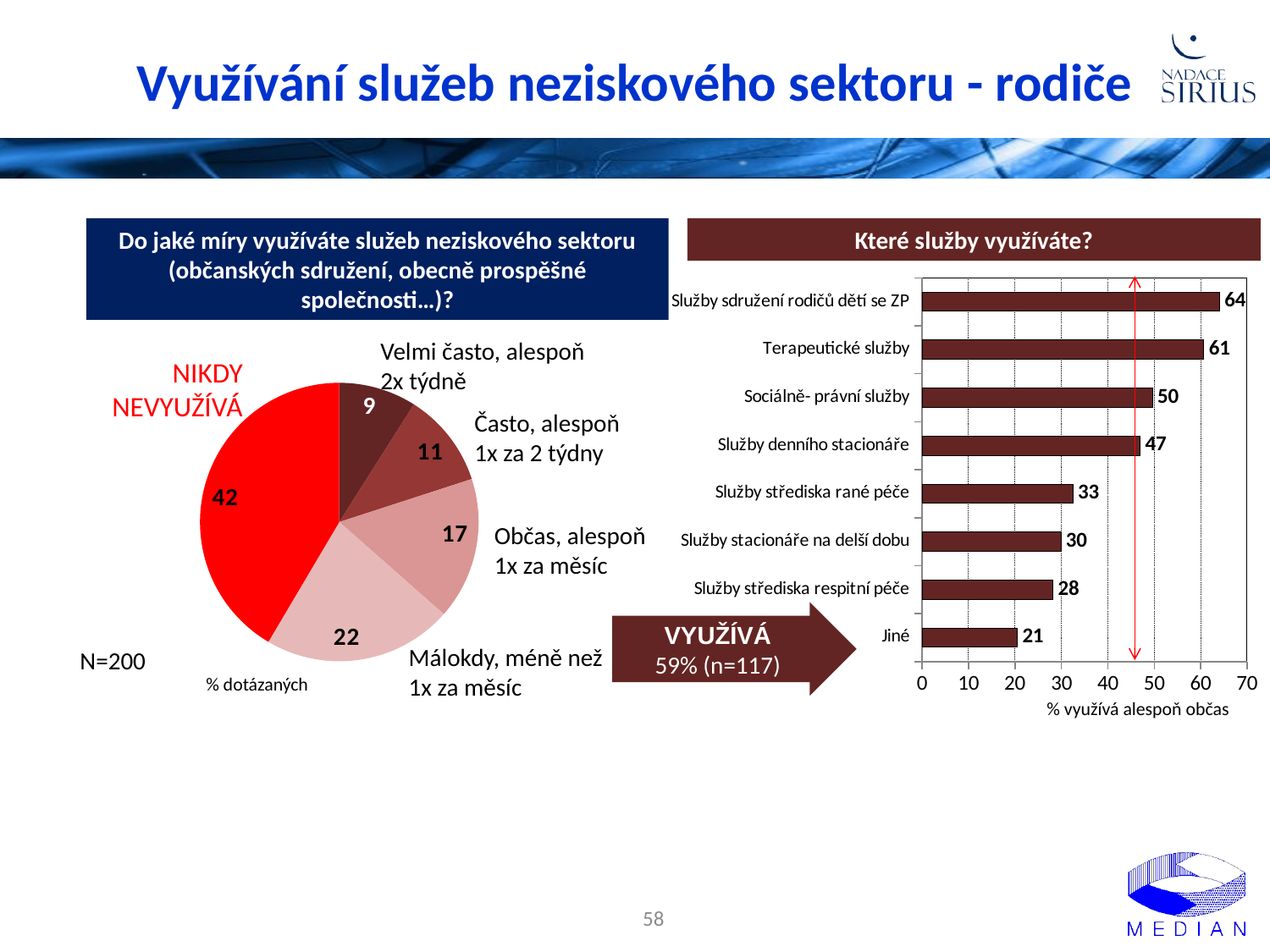
What type of chart is the 'Které služby využíváte?' chart? Bar chart In the 'Které služby využíváte?' chart, what is the difference between 'Sociálně- právní služby' and 'Služby denního stacionáře'? 3 In the pie chart on the left, which category has the smallest slice? Velmi často, alespoň 2x týdně In the pie chart on the left, how many slices are there? 5 In the pie chart on the left, what percentage of respondents answered 'NIKDY NEVYUŽÍVÁ'? 42 In the pie chart on the left, what is the difference between 'Málokdy, méně než 1x za měsíc' and 'Občas, alespoň 1x za měsíc'? 5 In the pie chart on the left, which category has the largest slice? NIKDY NEVYUŽÍVÁ In the 'Které služby využíváte?' chart, what is the value for 'Terapeutické služby'? 61 In the 'Které služby využíváte?' chart, which category has the lowest value? Jiné In the 'Které služby využíváte?' chart, which service has the highest value? Služby sdružení rodičů dětí se ZP In the 'Které služby využíváte?' chart, how many categories are shown? 8 In the pie chart on the left, what value is shown for 'Velmi často, alespoň 2x týdně'? 9